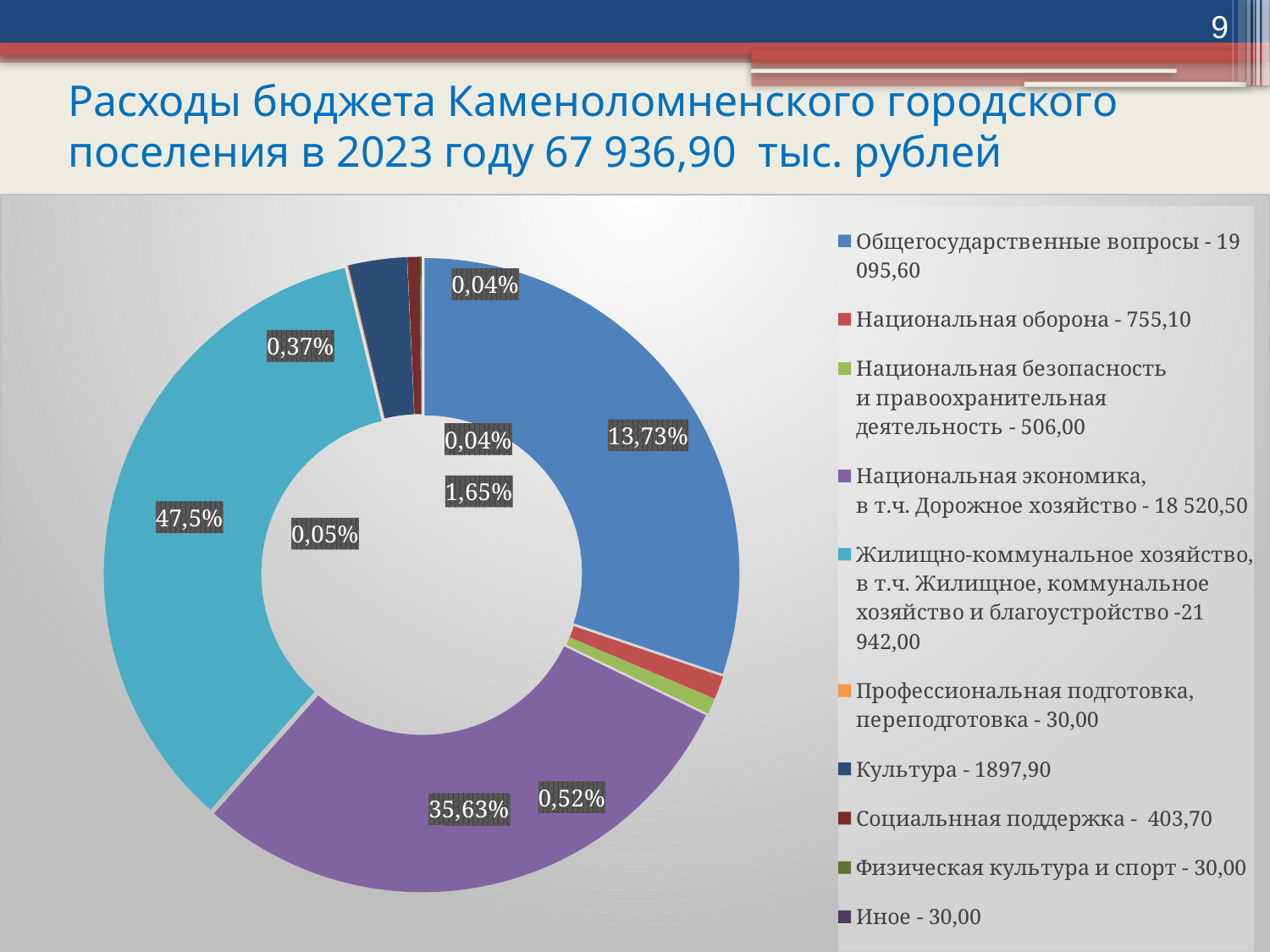
Which category has the largest value in the legend? Жилищно-коммунальное хозяйство What is the value given in the legend for Профессиональная подготовка, переподготовка? 30,00 What is the value given in the legend for Жилищно-коммунальное хозяйство? 21 942,00 What is the smallest value listed in the legend? 30,00 What total budget expenditure amount is stated in the slide title? 67 936,90 тыс. рублей What is the value given in the legend for Культура? 1897,90 How many expenditure categories does the legend list? 10 What is the difference between the legend values for Общегосударственные вопросы and Национальная экономика? 575,10 What is the difference between the legend values for Культура and Социальная поддержка? 1494,20 Which is larger according to the legend: Общегосударственные вопросы or Национальная экономика? Общегосударственные вопросы What kind of chart is shown on the slide? pie chart (doughnut) What is the value given in the legend for Национальная оборона? 755,10